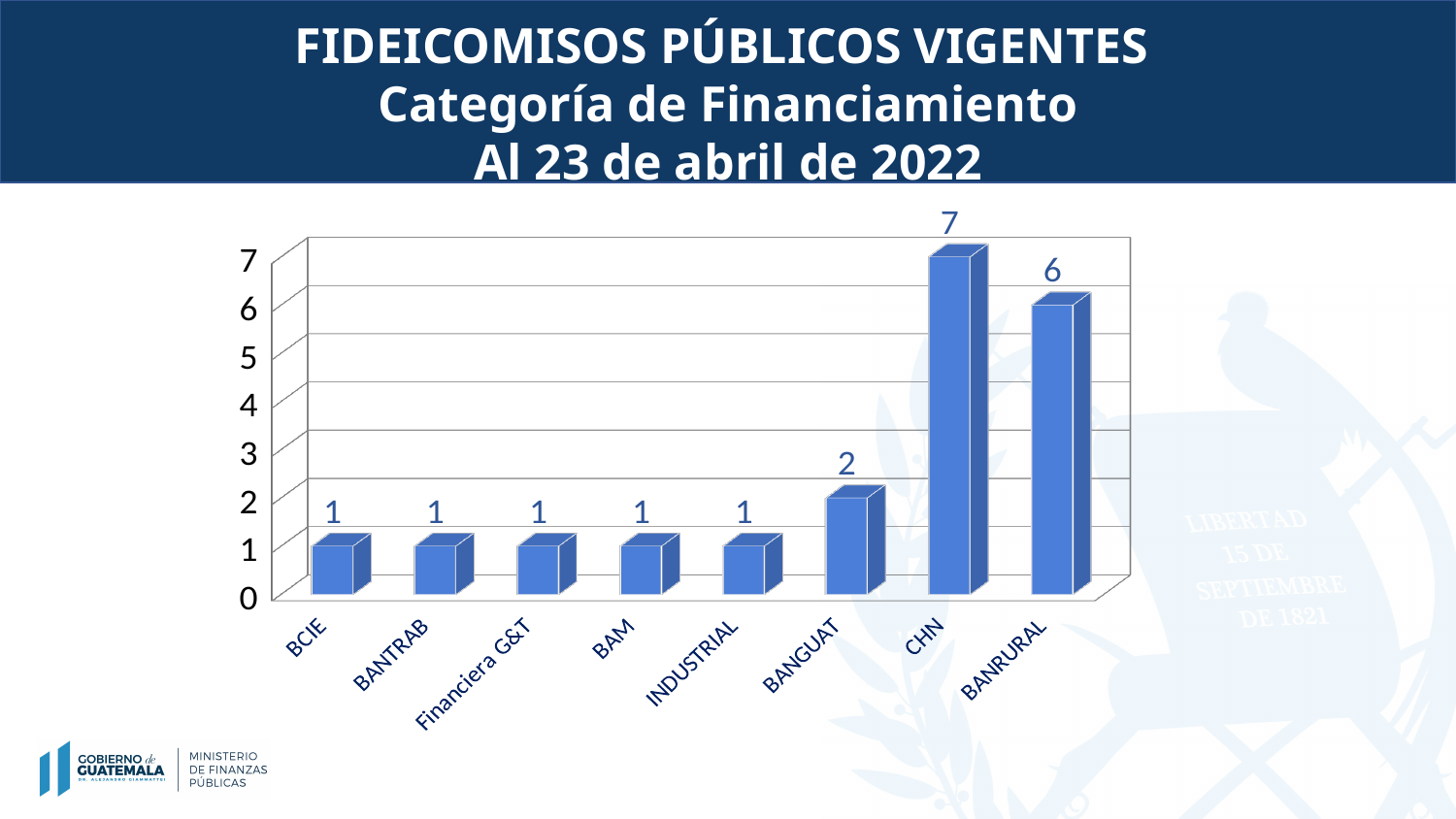
Is the value for CHN greater or less than 5? greater What is the value for BCIE? 1 What kind of chart is shown on the slide? bar chart What is the value for CHN? 7 What is the difference between the values for BANRURAL and BANGUAT? 4 Which is larger, the value for BANGUAT or the value for INDUSTRIAL? BANGUAT What is the difference between the values for CHN and BANRURAL? 1 What is the value for BANRURAL? 6 How many categories have a value of 1? 5 What is the value for BANGUAT? 2 How many categories are shown on the x axis? 8 Which category has the highest value? CHN